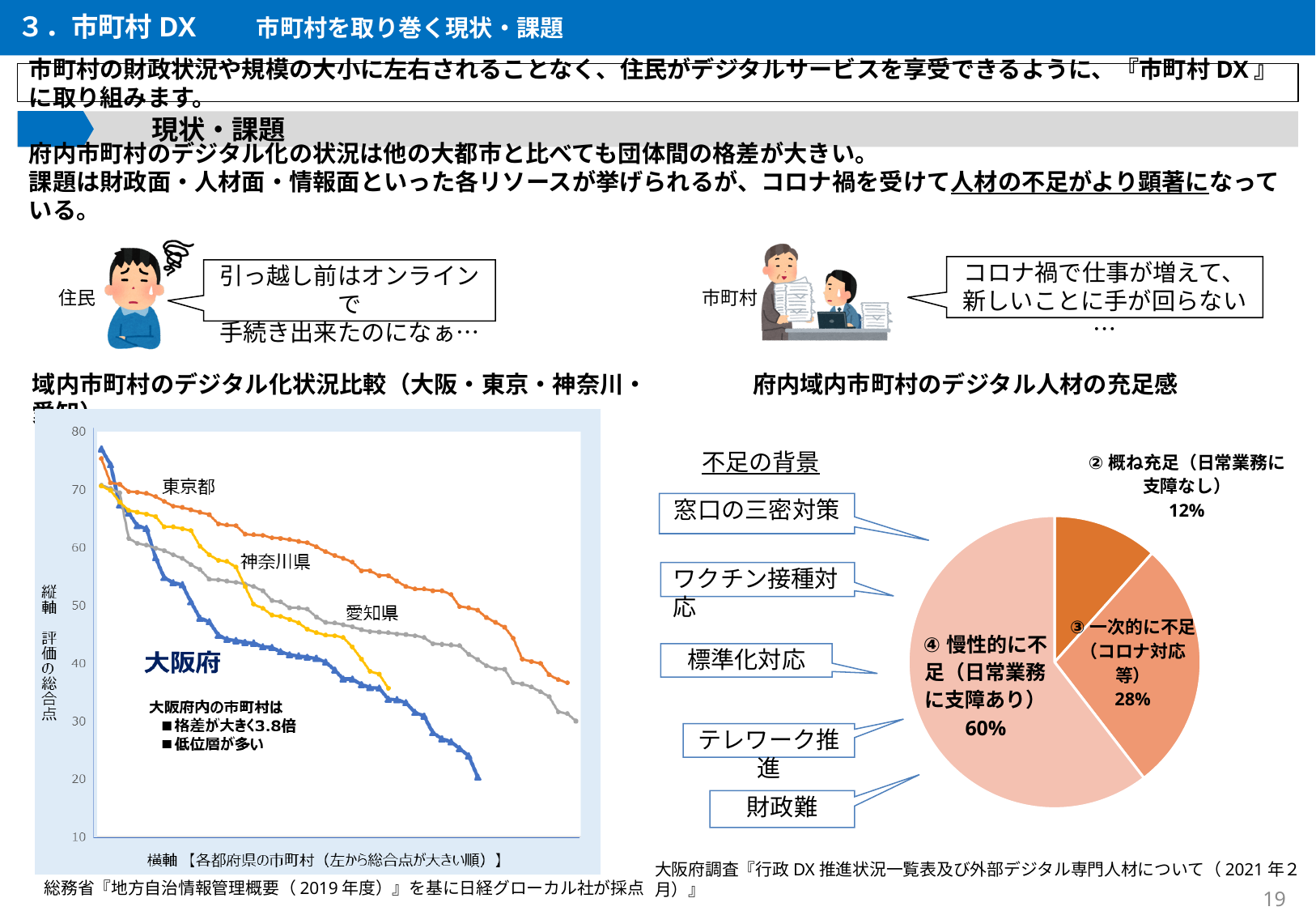
In the pie chart on the right, what share is ② 概ね充足（日常業務に支障なし）? 12% In the line chart on the left, do the lines rise or fall from left to right? Fall In the pie chart on the right (府内域内市町村のデジタル人材の充足感), what share is ④ 慢性的に不足（日常業務に支障あり）? 60% In the pie chart on the right, which category has the smallest slice? ② 概ね充足（日常業務に支障なし） In the line chart on the left, how many prefectures are plotted as lines? 4 How many slices does the pie chart on the right have? 3 What kind of chart is the chart on the right of the slide? Pie chart What kind of chart is the chart on the left (域内市町村のデジタル化状況比較)? Line chart In the pie chart on the right, what share is ③ 一次的に不足（コロナ対応等）? 28% In the pie chart on the right, which category has the largest slice? ④ 慢性的に不足（日常業務に支障あり） In the pie chart on the right, how many percentage points larger is ④ 慢性的に不足 than ③ 一次的に不足? 32 percentage points In the line chart on the left, is the lowest point of the 大阪府 line greater or less than 30? less